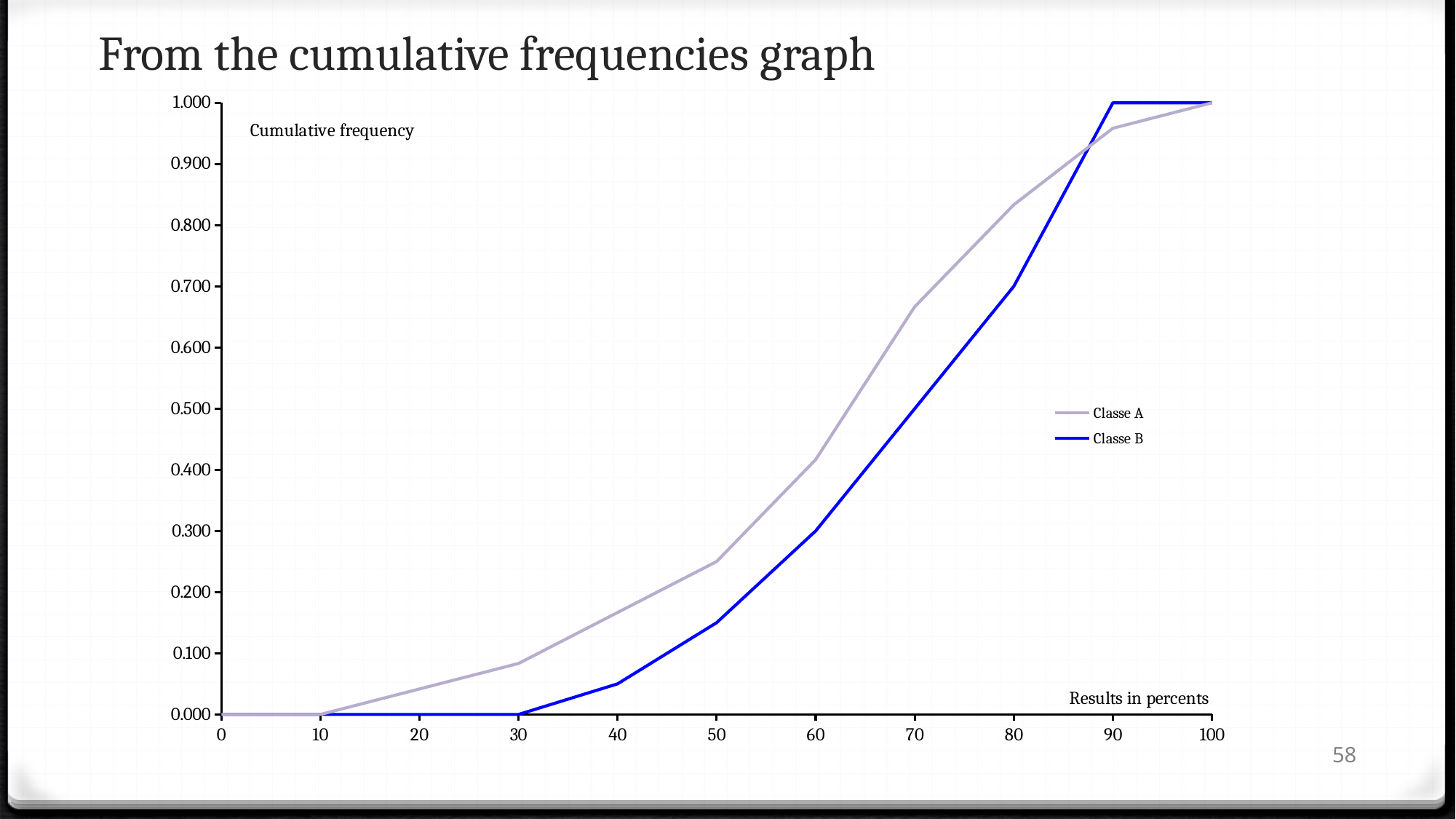
Do the cumulative frequency values for Classe A rise or fall as the results increase along the x axis? rise What type of chart is shown on the slide? line chart Is the cumulative frequency for Classe A at a result of 80 greater or less than 0.800? greater What is the cumulative frequency for Classe B at a result of 30? 0.000 How many series does the legend list? 2 At a result of 90, which series has the higher cumulative frequency, Classe A or Classe B? Classe B Is the cumulative frequency for Classe B at a result of 40 greater or less than 0.100? less At a result of 50, which series has the higher cumulative frequency, Classe A or Classe B? Classe A What is the cumulative frequency for Classe B at a result of 90? 1.000 Is the cumulative frequency for Classe A at a result of 50 greater or less than 0.200? greater What is the cumulative frequency for Classe A at a result of 10? 0.000 What is the cumulative frequency for Classe A at a result of 100? 1.000